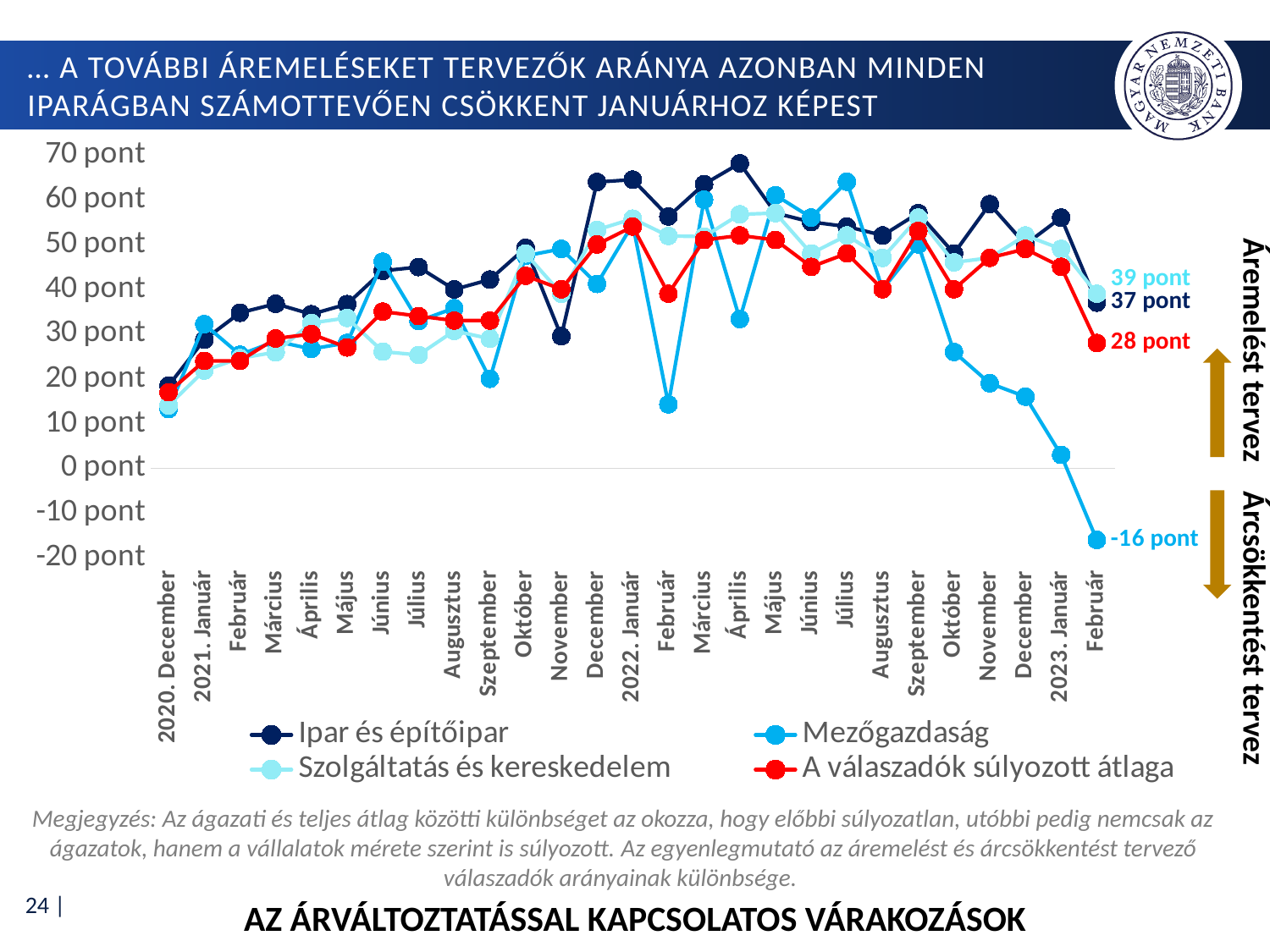
What is the value for Mezőgazdaság in 2023 Február? -16 pont How many months are shown along the x axis? 27 What is the value for Ipar és építőipar in 2023 Február? 37 pont What is the value for A válaszadók súlyozott átlaga in 2023 Február? 28 pont What is the value for Szolgáltatás és kereskedelem in 2023 Február? 39 pont What is the difference between Ipar és építőipar and Mezőgazdaság in 2023 Február? 53 pont Which series is drawn in red in the legend? A válaszadók súlyozott átlaga Which series has the lowest value in 2023 Február? Mezőgazdaság Does the Mezőgazdaság series rise or fall from 2022 Szeptember to 2023 Február? fall What kind of chart is shown on the slide? line chart Is the value for Ipar és építőipar in 2022 Április greater or less than 60 pont? greater How many series does the legend list? 4